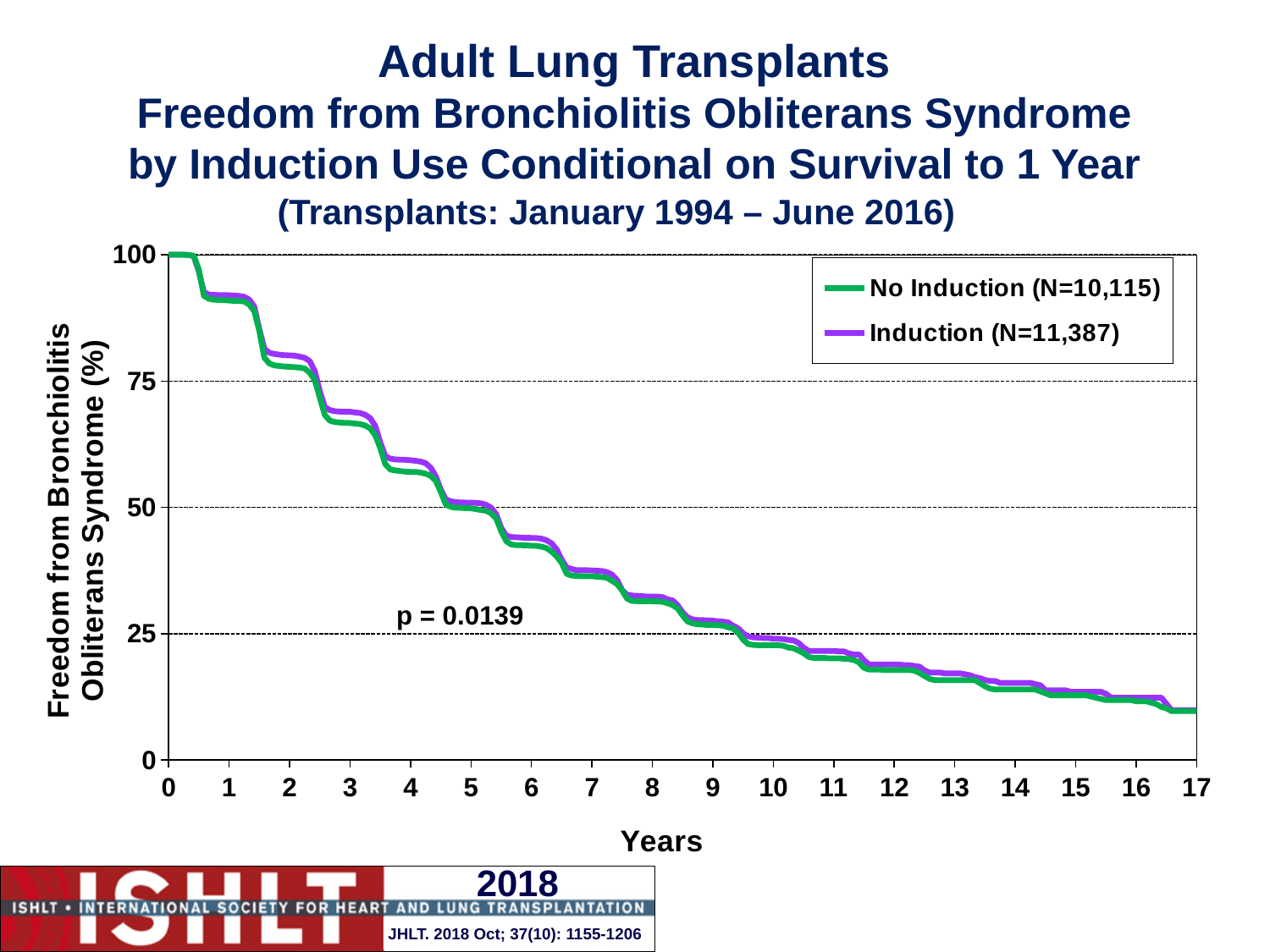
Is the value for the No Induction curve at year 1 greater or less than 75? greater Do the values for freedom from bronchiolitis obliterans syndrome rise or fall as years increase? fall What is the value for both curves at year 0? 100 What is the p-value shown on the chart? p = 0.0139 Is the value for the Induction curve at year 8 greater or less than 25? greater Is the value for the Induction curve at year 3 greater or less than 75? less How many series does the legend list? 2 What is the maximum value shown on the x axis (Years)? 17 What kind of chart is shown on the slide? line chart What is the N for the Induction group shown in the legend? N=11,387